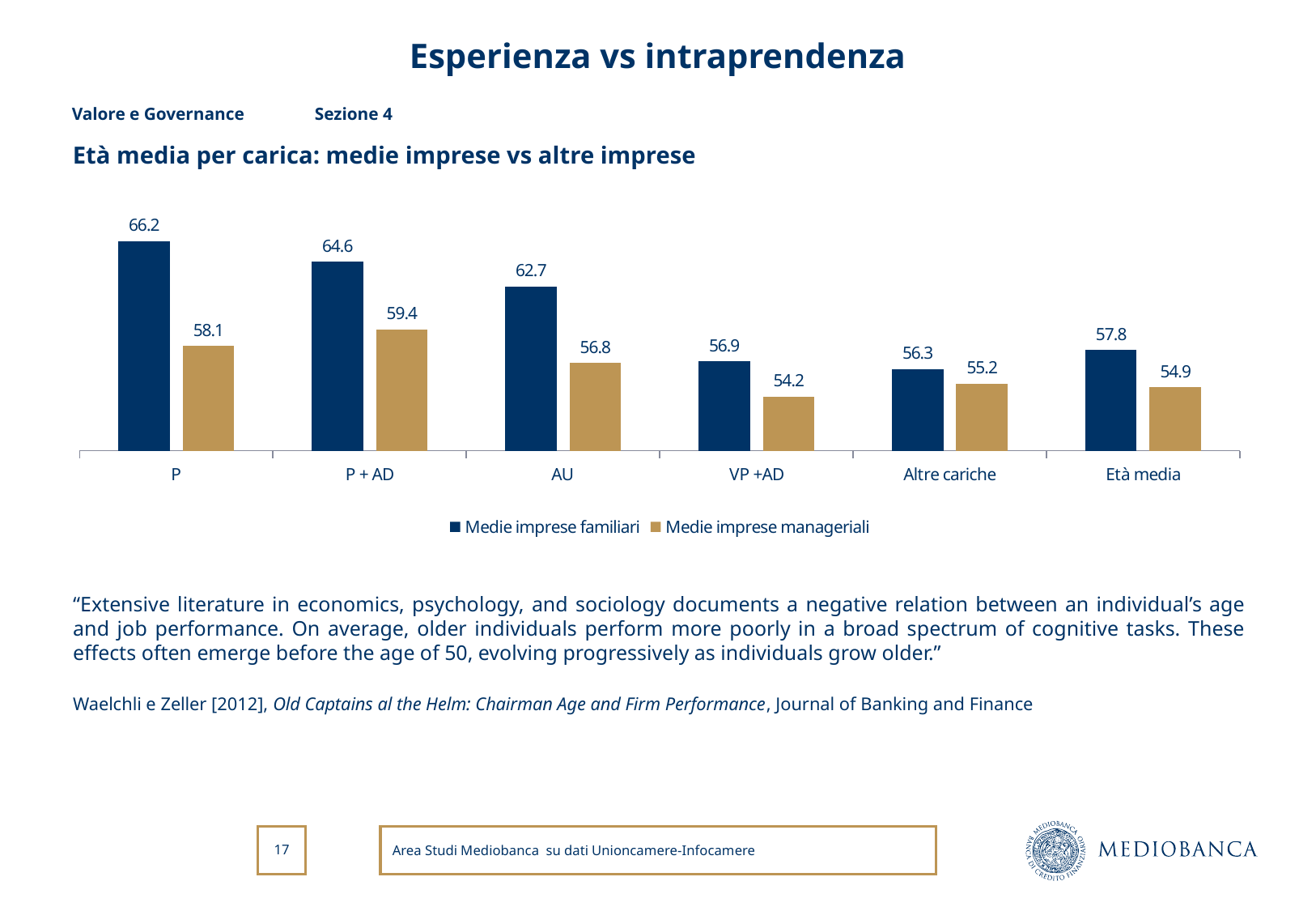
Which category has the lowest value for Medie imprese manageriali? VP +AD What kind of chart is shown on the slide? Bar chart How many series does the legend list? 2 What is the difference between Medie imprese familiari and Medie imprese manageriali in the P + AD category? 5.2 What is the value for Medie imprese familiari in the P category? 66.2 What is the value for Medie imprese manageriali in the AU category? 56.8 What is the value for Medie imprese manageriali in the Età media category? 54.9 Which category has the highest value for Medie imprese familiari? P How many categories are shown on the x axis? 6 Do the values for Medie imprese familiari rise or fall from P to Altre cariche? Fall What is the title of the chart? Età media per carica: medie imprese vs altre imprese Which is larger in the Altre cariche category: Medie imprese familiari or Medie imprese manageriali? Medie imprese familiari